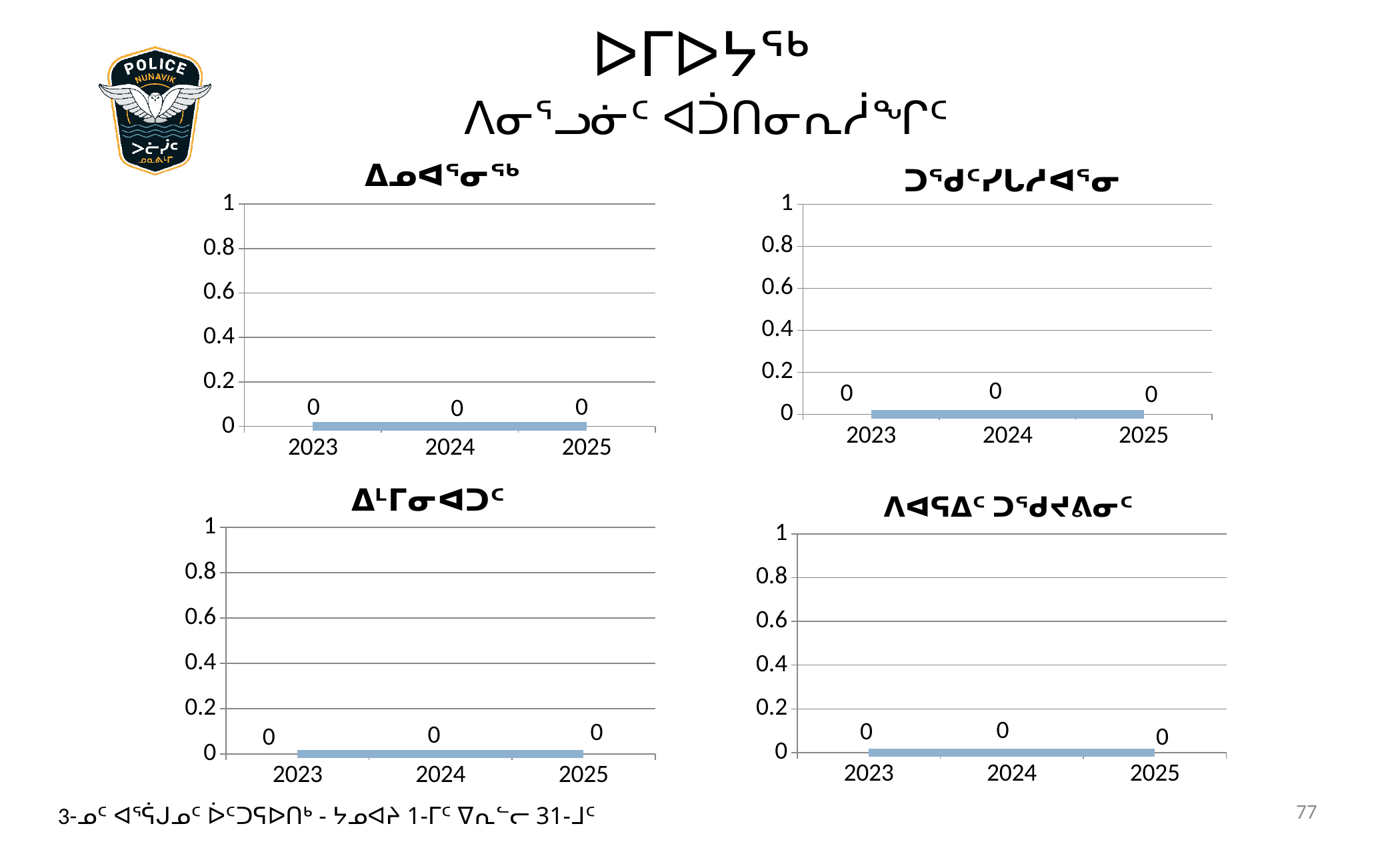
In the top-left chart, what is the value for 2023? 0 In the bottom-left chart, what is the value for 2025? 0 What is the highest tick value on the y axis of the top-left chart? 1 In the bottom-right chart, what is the value for 2023? 0 How many years are shown on the x axis of the top-left chart? 3 In the top-right chart, what is the value for 2024? 0 In the bottom-left chart, do the values rise, fall, or stay flat from 2023 to 2025? stay flat How many charts are on the slide? 4 What kind of chart is the bottom-right chart? line chart In the top-left chart, is the value for 2024 greater or less than 0.2? less In the top-right chart, what is the difference between the values for 2025 and 2023? 0 Which year is the first category on the x axis of the bottom-right chart? 2023